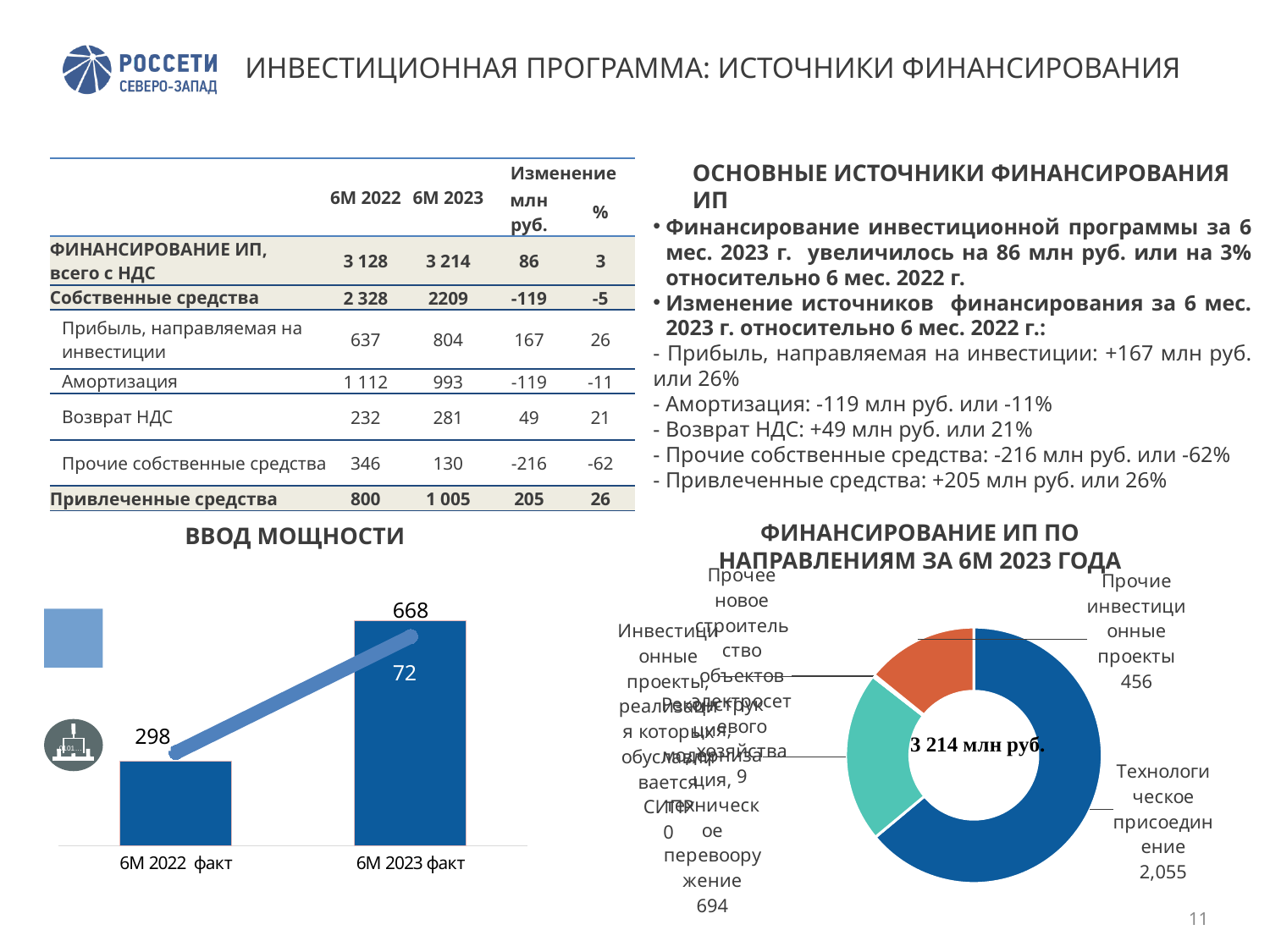
What kind of chart is the 'ВВОД МОЩНОСТИ' chart? combination bar and line chart In the 'ВВОД МОЩНОСТИ' chart, what is the difference between the 6М 2023 факт and 6М 2022 факт values? 370 In the 'ВВОД МОЩНОСТИ' chart, do the values rise or fall from 6М 2022 факт to 6М 2023 факт? rise In the 'ФИНАНСИРОВАНИЕ ИП ПО НАПРАВЛЕНИЯМ ЗА 6М 2023 ГОДА' chart, what is the value for Технологическое присоединение? 2,055 In the 'ВВОД МОЩНОСТИ' chart, what is the value for 6М 2022 факт? 298 What kind of chart is the 'ФИНАНСИРОВАНИЕ ИП ПО НАПРАВЛЕНИЯМ ЗА 6М 2023 ГОДА' chart? doughnut chart In the 'ВВОД МОЩНОСТИ' chart, which bar is larger, 6М 2022 факт or 6М 2023 факт? 6М 2023 факт What total is printed in the centre of the 'ФИНАНСИРОВАНИЕ ИП ПО НАПРАВЛЕНИЯМ ЗА 6М 2023 ГОДА' chart? 3 214 млн руб. How many bars are shown in the 'ВВОД МОЩНОСТИ' chart? 2 In the 'ВВОД МОЩНОСТИ' chart, what is the value for 6М 2023 факт? 668 In the 'ФИНАНСИРОВАНИЕ ИП ПО НАПРАВЛЕНИЯМ ЗА 6М 2023 ГОДА' chart, what is the value for Прочие инвестиционные проекты? 456 In the 'ФИНАНСИРОВАНИЕ ИП ПО НАПРАВЛЕНИЯМ ЗА 6М 2023 ГОДА' chart, which category has the largest slice? Технологическое присоединение